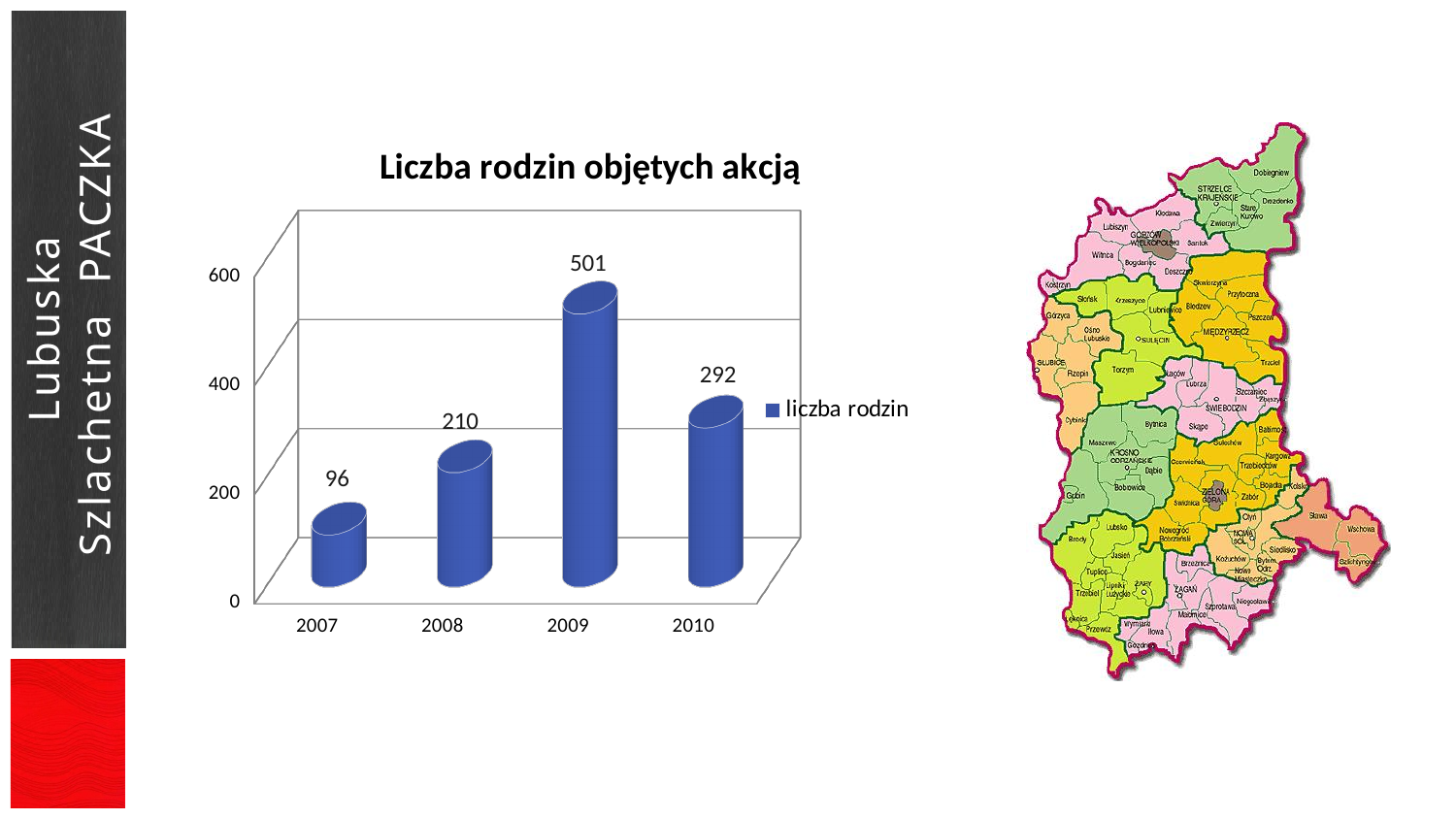
What kind of chart is shown on the slide? bar chart What is the value for 2009 in the chart? 501 What is the value for 2010 in the chart? 292 How many years are shown on the x axis of the chart? 4 How many series does the legend list? 1 What is the title of the chart? Liczba rodzin objętych akcją What is the difference between the values for 2009 and 2010? 209 Which year has the highest number of families? 2009 What is the value for 2007 in the chart? 96 Which is larger, the value for 2008 or the value for 2010? 2010 Which year has the lowest number of families? 2007 What is the difference between the values for 2008 and 2007? 114